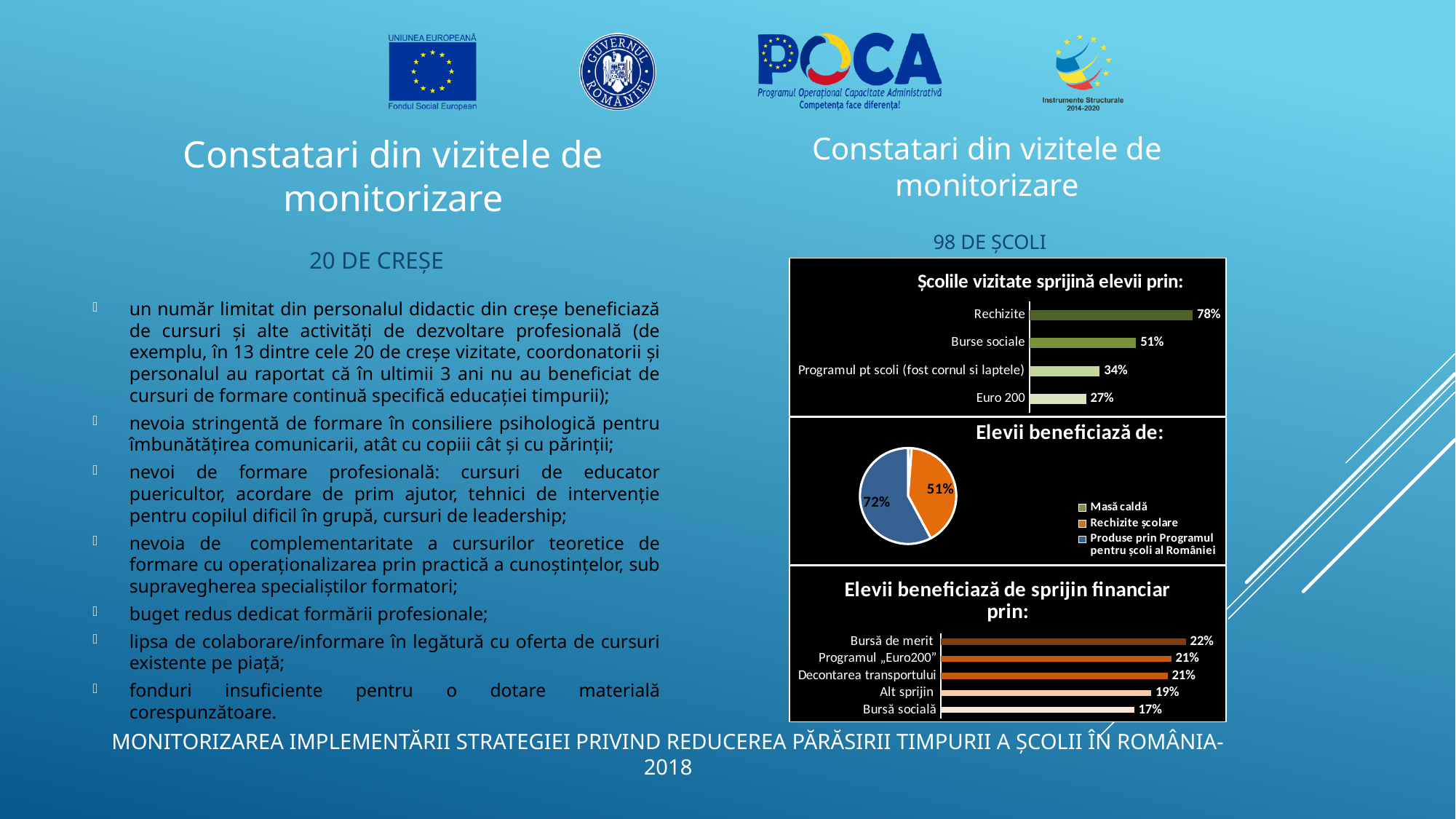
In the chart titled "Școlile vizitate sprijină elevii prin:", what is the value for Euro 200? 27% In the chart titled "Elevii beneficiază de sprijin financiar prin:", which category has the lowest value? Bursă socială In the chart titled "Școlile vizitate sprijină elevii prin:", which category has the lowest value? Euro 200 In the chart titled "Școlile vizitate sprijină elevii prin:", what is the difference between Rechizite and Burse sociale? 27% In the chart titled "Școlile vizitate sprijină elevii prin:", what is the value for Rechizite? 78% In the chart titled "Școlile vizitate sprijină elevii prin:", how many categories are shown? 4 In the chart titled "Elevii beneficiază de sprijin financiar prin:", what is the value for Bursă de merit? 22% In the pie chart titled "Elevii beneficiază de:", which slice is the largest? Produse prin Programul pentru școli al României In the chart titled "Elevii beneficiază de sprijin financiar prin:", how many categories are shown? 5 In the pie chart titled "Elevii beneficiază de:", how many entries does the legend list? 3 In the chart titled "Elevii beneficiază de sprijin financiar prin:", what is the difference between Bursă de merit and Alt sprijin? 3% What kind of chart is the one titled "Elevii beneficiază de:"? Pie chart